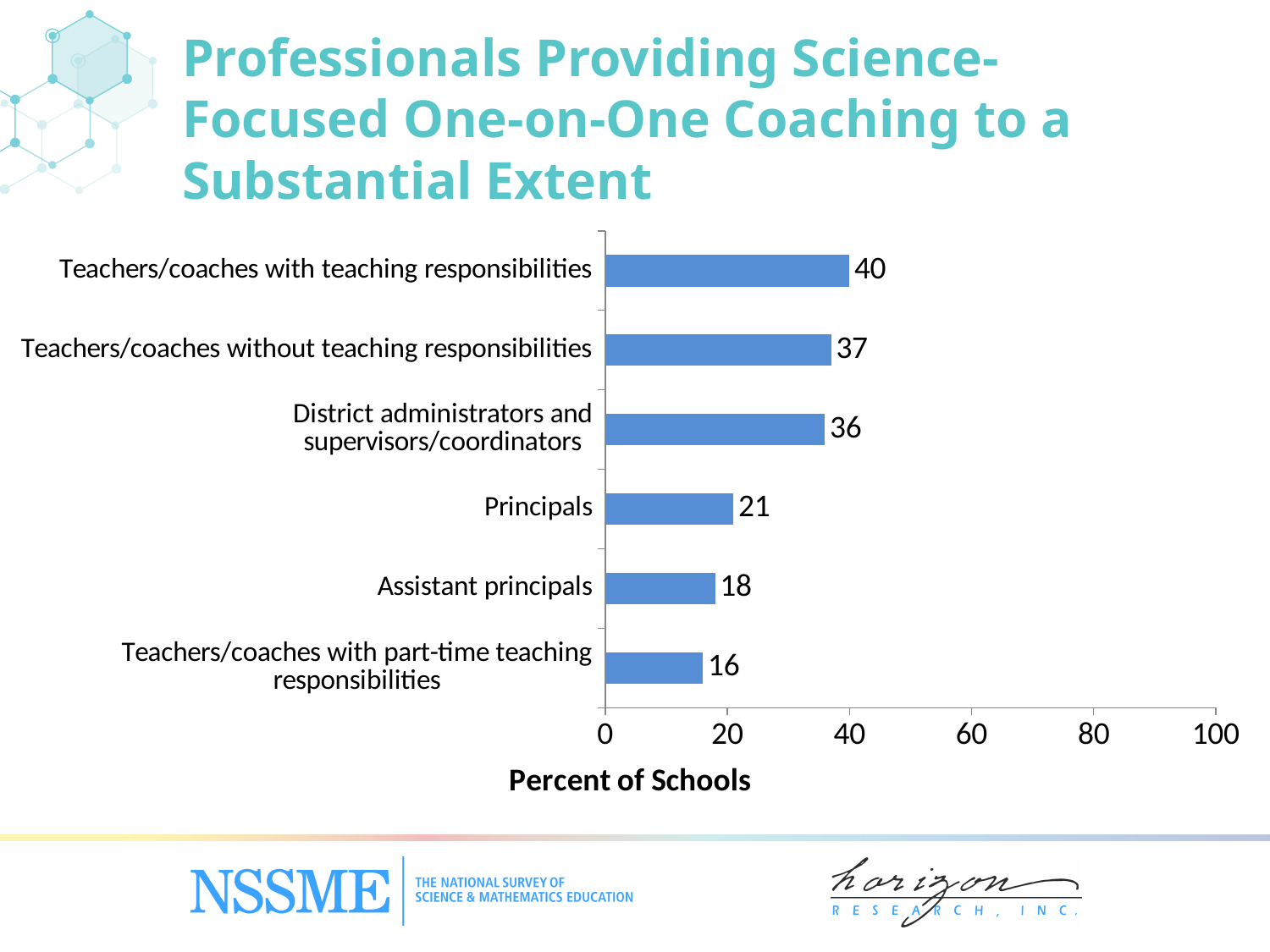
What is the maximum value shown on the horizontal axis? 100 Which category has the highest value? Teachers/coaches with teaching responsibilities What is the value for Teachers/coaches without teaching responsibilities? 37 Which is larger, the value for District administrators and supervisors/coordinators or the value for Assistant principals? District administrators and supervisors/coordinators What kind of chart is shown on the slide? bar chart What is the value for Assistant principals? 18 Is the value for Teachers/coaches with part-time teaching responsibilities greater or less than 20? less What is the value for Principals? 21 What is the label of the horizontal axis? Percent of Schools Which category has the lowest value? Teachers/coaches with part-time teaching responsibilities How many categories are shown in the chart? 6 What is the difference between the values for Teachers/coaches with teaching responsibilities and Principals? 19